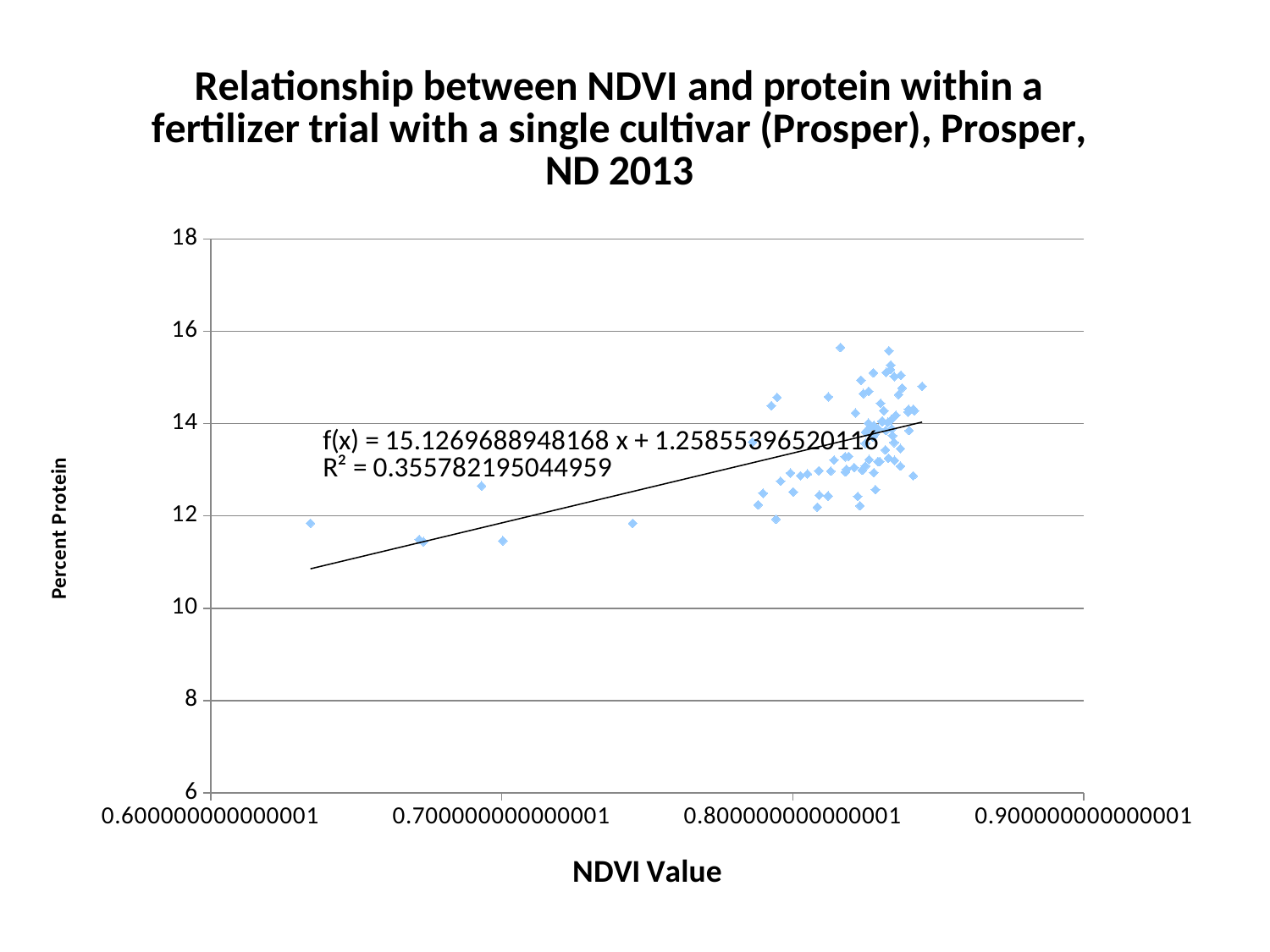
What is the maximum value shown on the y axis? 18 What is the title of the y axis? Percent Protein What is the R² value shown on the chart? 0.355782195044959 Is the lowest plotted percent protein value greater or less than 12? less According to the trendline, does percent protein rise or fall as NDVI value increases? rise What kind of chart is shown on the slide? scatter chart Is the highest plotted percent protein value greater or less than 14? greater What is the title of the x axis? NDVI Value What is the intercept of the fitted line equation shown on the chart? 1.25855396520116 What is the minimum value shown on the y axis? 6 What is the slope of the fitted line equation shown on the chart? 15.1269688948168